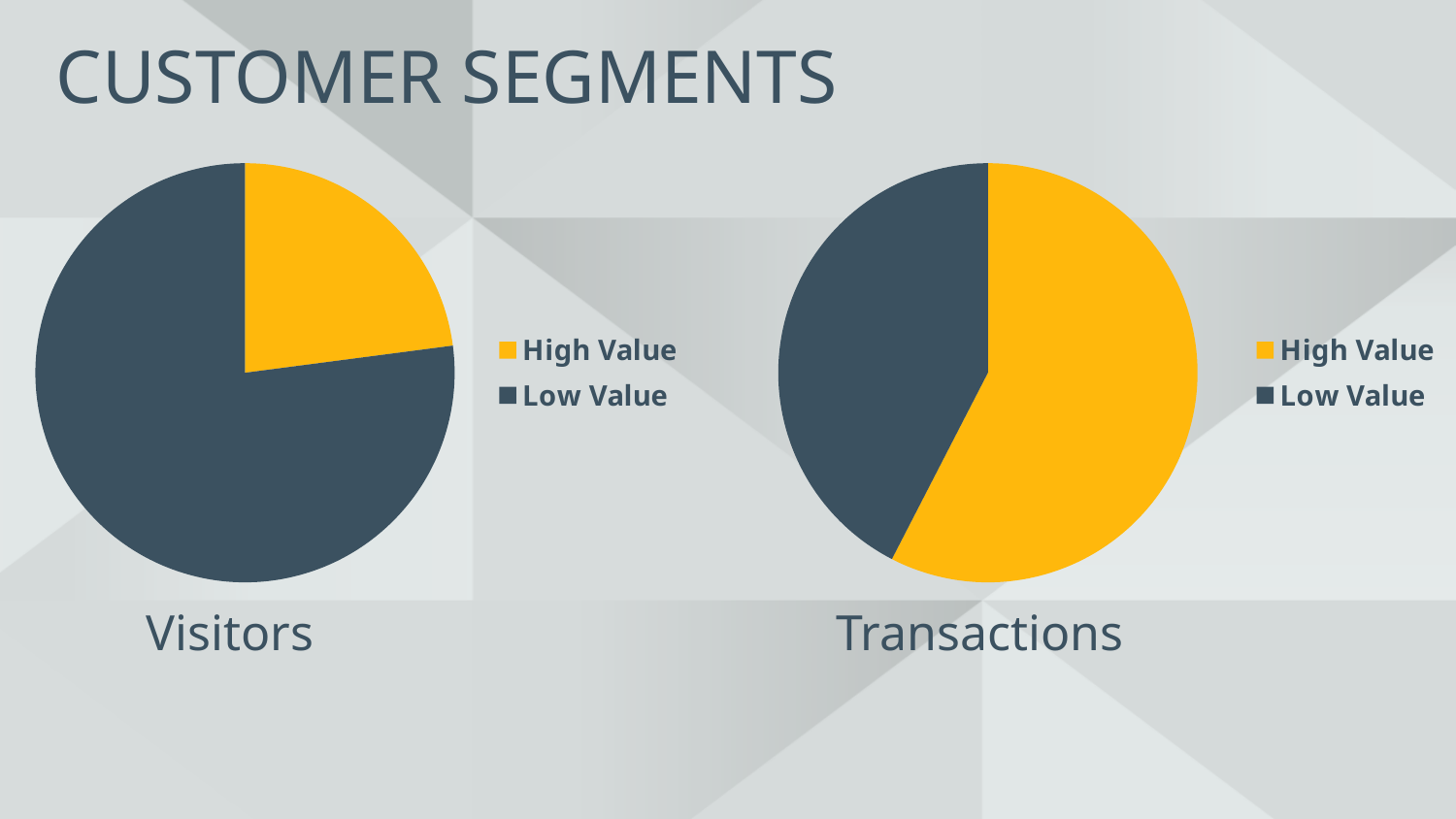
In the Transactions chart, which is larger: High Value or Low Value? High Value In the Visitors chart, which segment is the smallest? High Value In the Visitors chart, which is larger: High Value or Low Value? Low Value In the Transactions chart, which segment is the smallest? Low Value How many entries does the legend of the Transactions chart list? 2 In the Visitors chart, which segment is the largest? Low Value What colour represents High Value in the Visitors chart? yellow In the Transactions chart, which segment is the largest? High Value What kind of chart is the Transactions chart? pie chart What kind of chart is the Visitors chart? pie chart What is the title of the slide containing the two pie charts? CUSTOMER SEGMENTS How many slices does the Visitors pie chart have? 2